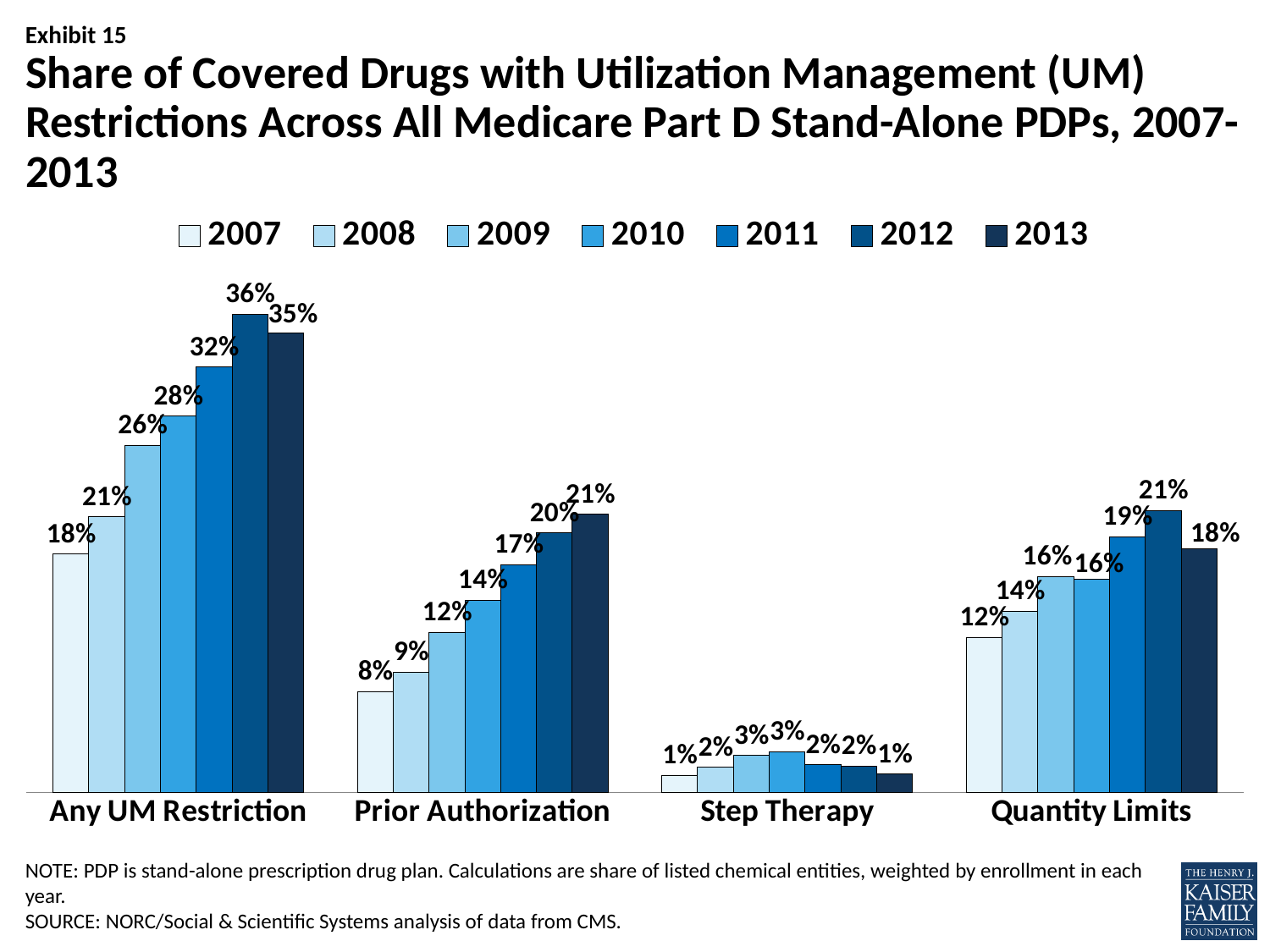
What is the value for Step Therapy in 2009? 3% Which is larger in 2012: Prior Authorization or Quantity Limits? Quantity Limits How many series does the legend list? 7 Do the values for Prior Authorization rise or fall from 2007 to 2013? Rise What is the value for Prior Authorization in 2007? 8% In which year was the value for Any UM Restriction highest? 2012 What is the value for Any UM Restriction in 2013? 35% What is the difference between the 2013 and 2007 values for Prior Authorization? 13% Which category has the lowest value in 2013? Step Therapy What is the value for Quantity Limits in 2011? 19% What kind of chart is shown on the slide? Bar chart How many categories are shown on the x axis? 4